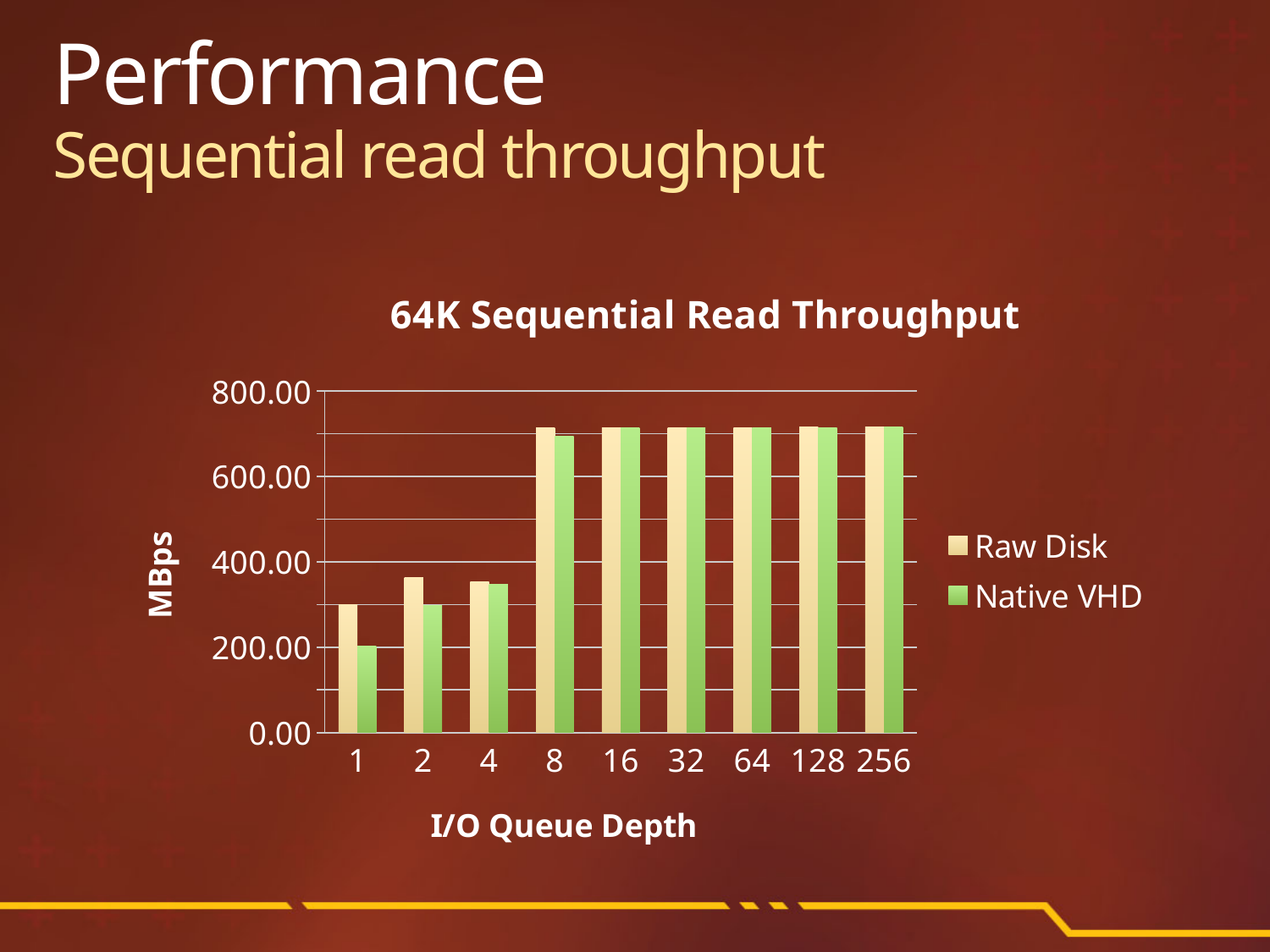
What kind of chart is shown on the slide? Bar chart Is the Raw Disk value at I/O queue depth 1 greater or less than 400? less Do the Native VHD values generally rise or fall as I/O queue depth increases? rise What is the label of the y axis? MBps At which I/O queue depth is the Native VHD value lowest? 1 Is the Raw Disk value at I/O queue depth 8 greater or less than 600? greater How many series does the legend list? 2 At I/O queue depth 1, which is larger: Raw Disk or Native VHD? Raw Disk Is the Native VHD value at I/O queue depth 256 greater or less than 600? greater What is the title of the chart? 64K Sequential Read Throughput How many I/O queue depth categories are shown on the x axis? 9